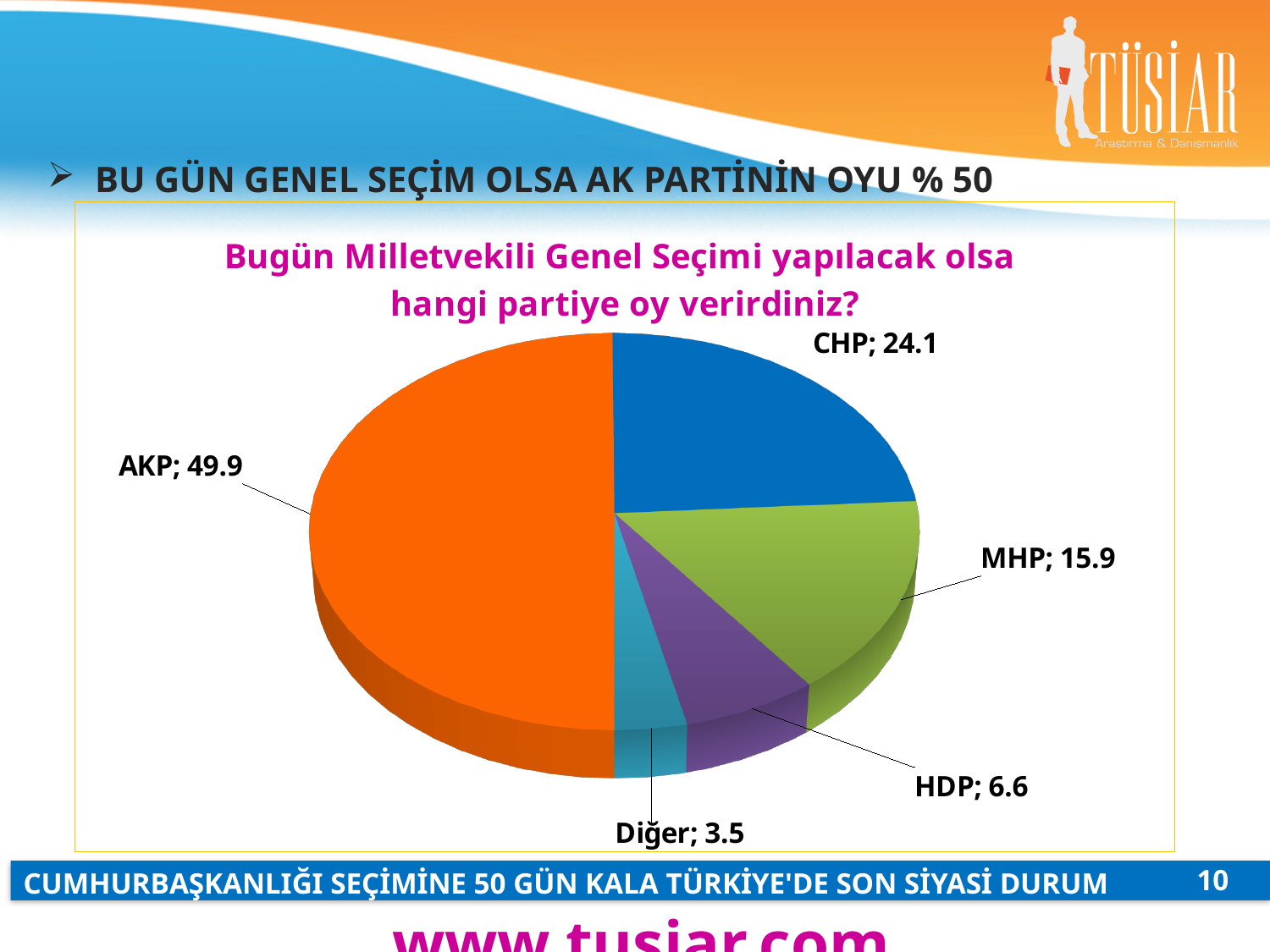
What is the value for Diğer in the pie chart? 3.5 Which party has the largest slice of the pie chart? AKP What is the title of the pie chart? Bugün Milletvekili Genel Seçimi yapılacak olsa hangi partiye oy verirdiniz? What kind of chart is shown on the slide? Pie chart What is the value for HDP in the pie chart? 6.6 What is the value for MHP in the pie chart? 15.9 Which is larger, the value for MHP or the value for HDP? MHP What is the value for CHP in the pie chart? 24.1 What is the value for AKP in the pie chart? 49.9 How many slices does the pie chart have? 5 What is the difference between the values for AKP and CHP? 25.8 Which category has the smallest slice of the pie chart? Diğer